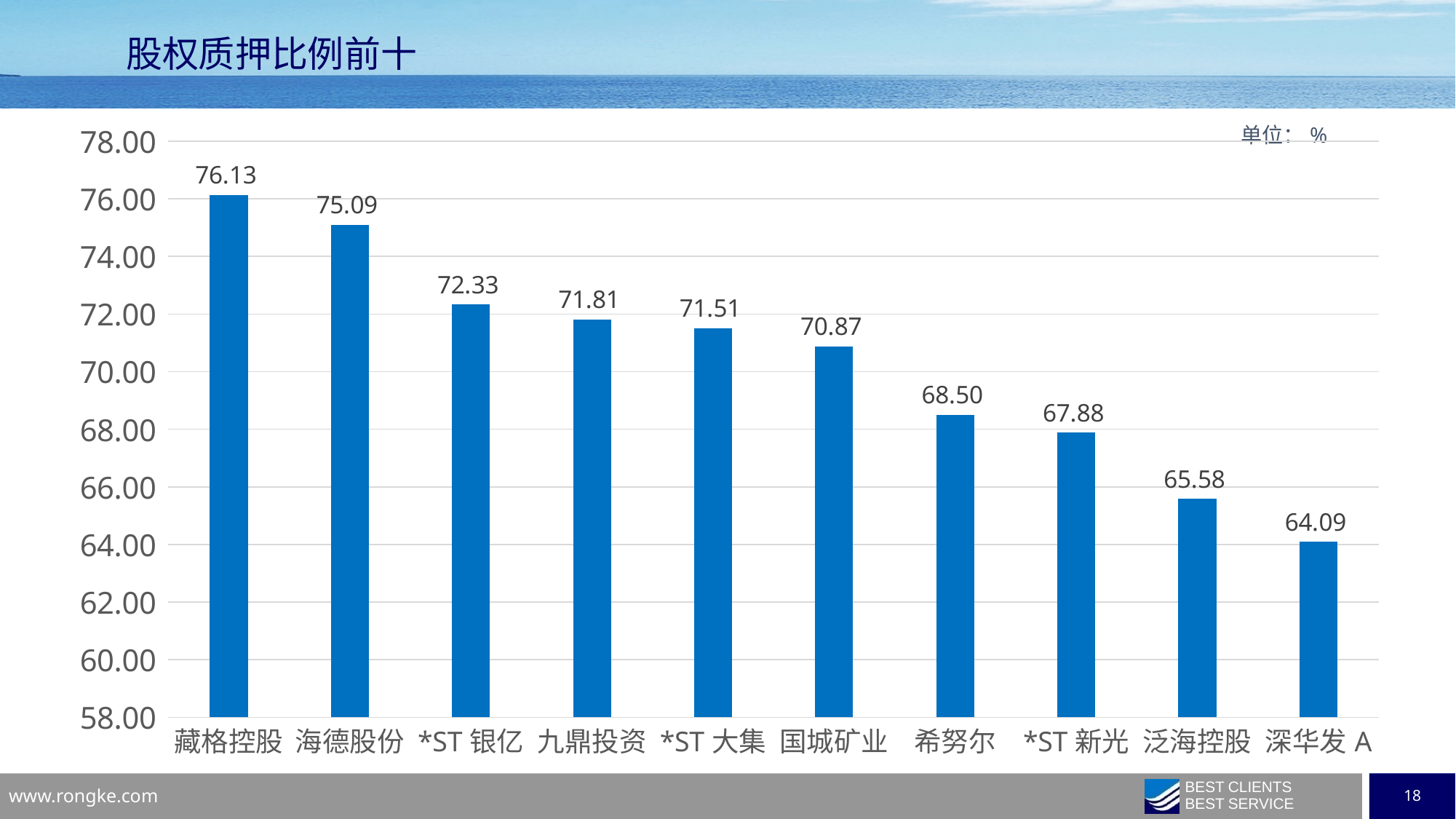
What is the value for 泛海控股? 65.58 Which category has the lowest value? 深华发 A What kind of chart is shown on the slide? bar chart How many categories are shown on the x axis? 10 What is the difference between the values for 希努尔 and *ST 新光? 0.62 What is the value for 国城矿业? 70.87 Do the values rise or fall from left to right along the x axis? fall Which is larger, the value for *ST 银亿 or the value for 九鼎投资? *ST 银亿 What is the value for 藏格控股? 76.13 Is the value for *ST 大集 greater or less than 70.00? greater What is the difference between the values for 藏格控股 and 海德股份? 1.04 Which category has the highest value? 藏格控股